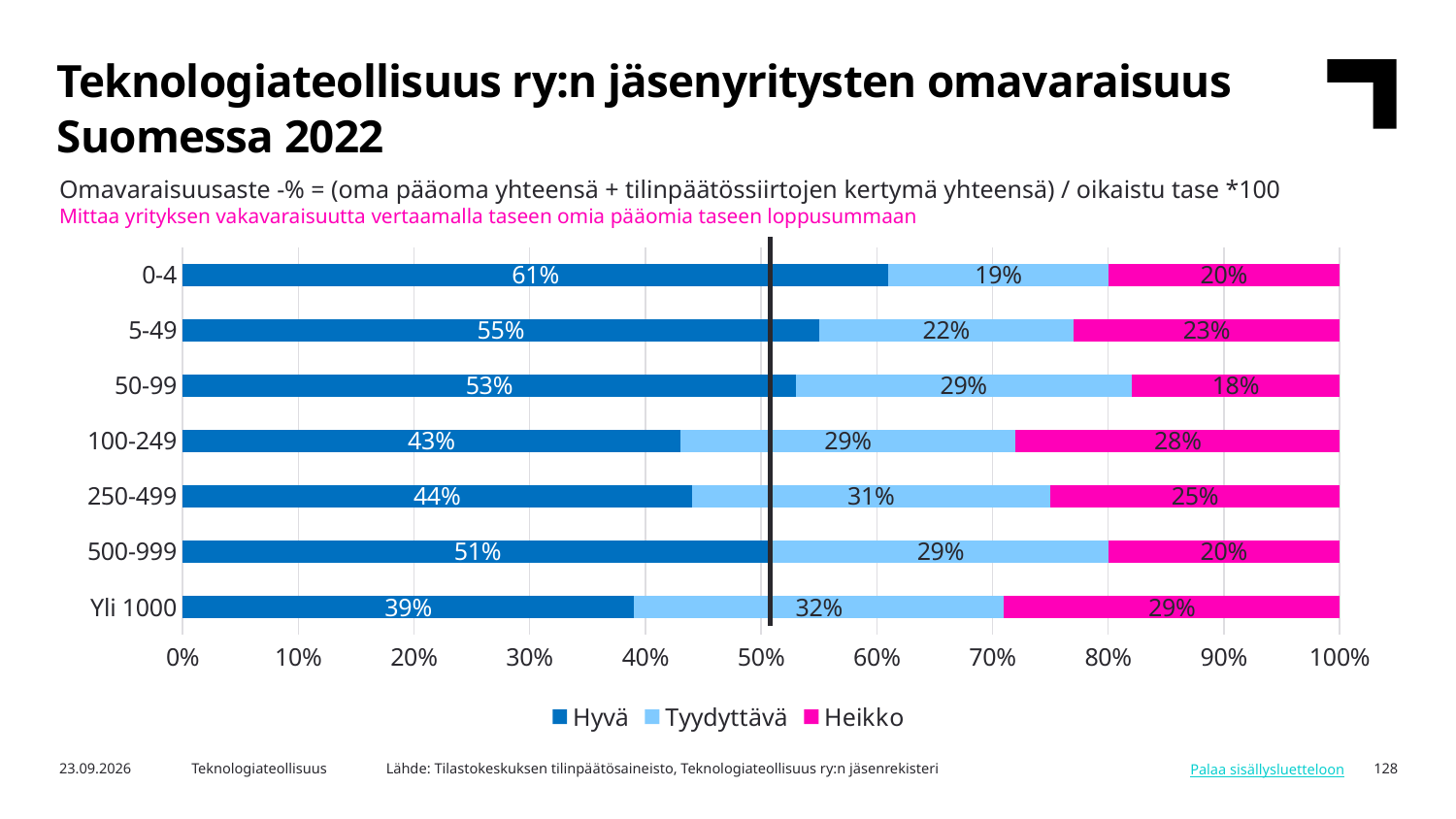
What is the total of the stacked bar for the 500-999 category? 100% Which is larger, the Tyydyttävä value for 250-499 or for 5-49? 250-499 How many size categories are shown on the chart? 7 What is the Hyvä value for the 0-4 category? 61% Which category has the highest Hyvä value? 0-4 Which series is shown in magenta in the legend? Heikko How many series does the legend list? 3 What is the Tyydyttävä value for the Yli 1000 category? 32% What kind of chart is shown on the slide? Stacked bar chart Which category has the lowest Heikko value? 50-99 What is the Heikko value for the 100-249 category? 28% What is the difference between the Hyvä values for 0-4 and Yli 1000? 22 percentage points